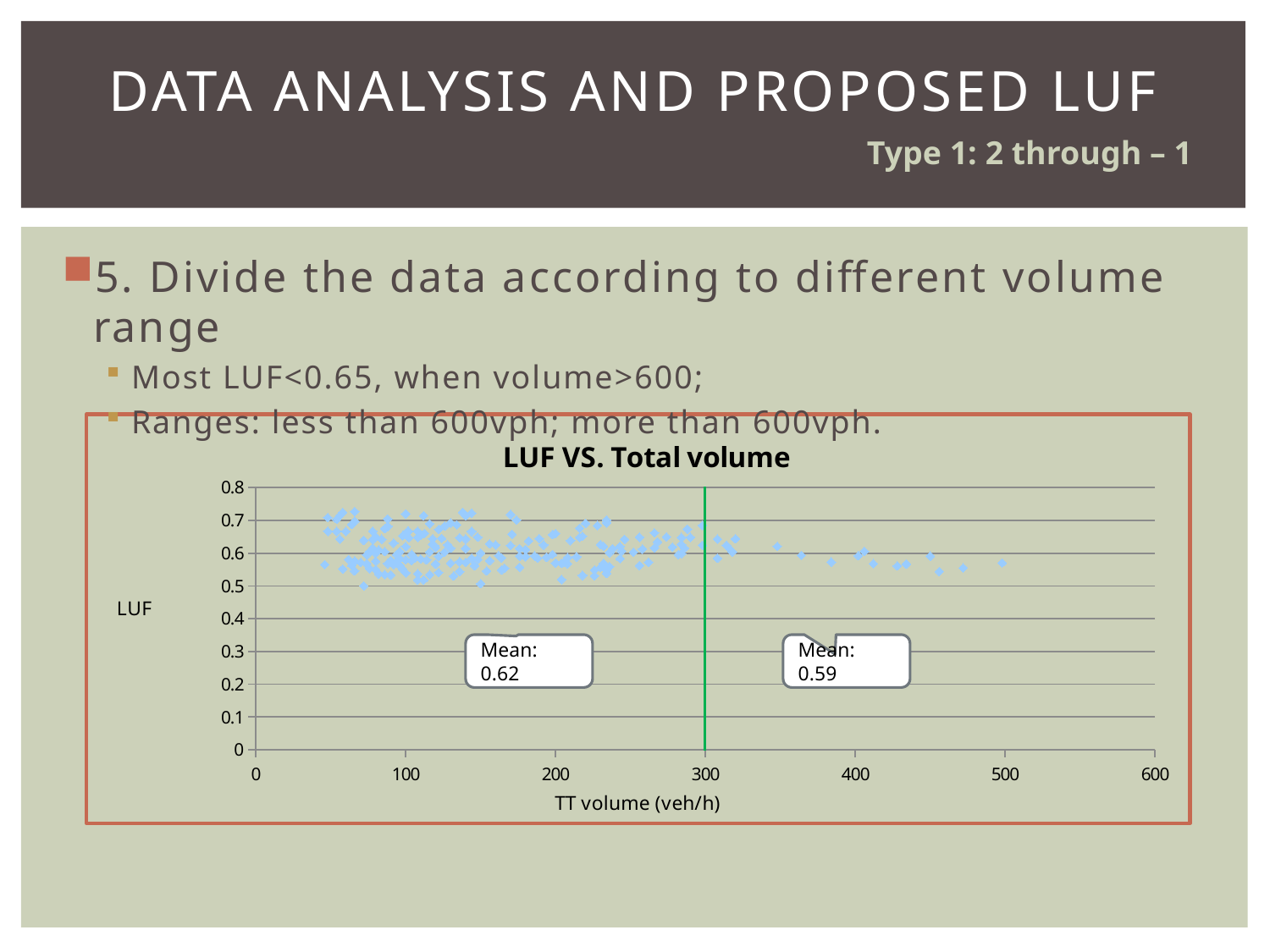
What is the label of the x axis of the chart? TT volume (veh/h) Which annotated mean is larger, the one on the left of the green line or the one on the right? The one on the left (0.62) Do the LUF values generally rise or fall as TT volume increases? fall What is the title of the chart? LUF VS. Total volume What is the maximum value shown on the x axis? 600 What kind of chart is shown on the slide? Scatter chart Are the plotted LUF values greater or less than 0.4? greater What is the difference between the two annotated mean values? 0.03 What mean LUF value is annotated for the data to the right of the vertical green line? 0.59 What mean LUF value is annotated for the data to the left of the vertical green line? 0.62 Are the plotted LUF values greater or less than 0.8? less At what TT volume value is the vertical green line drawn? 300